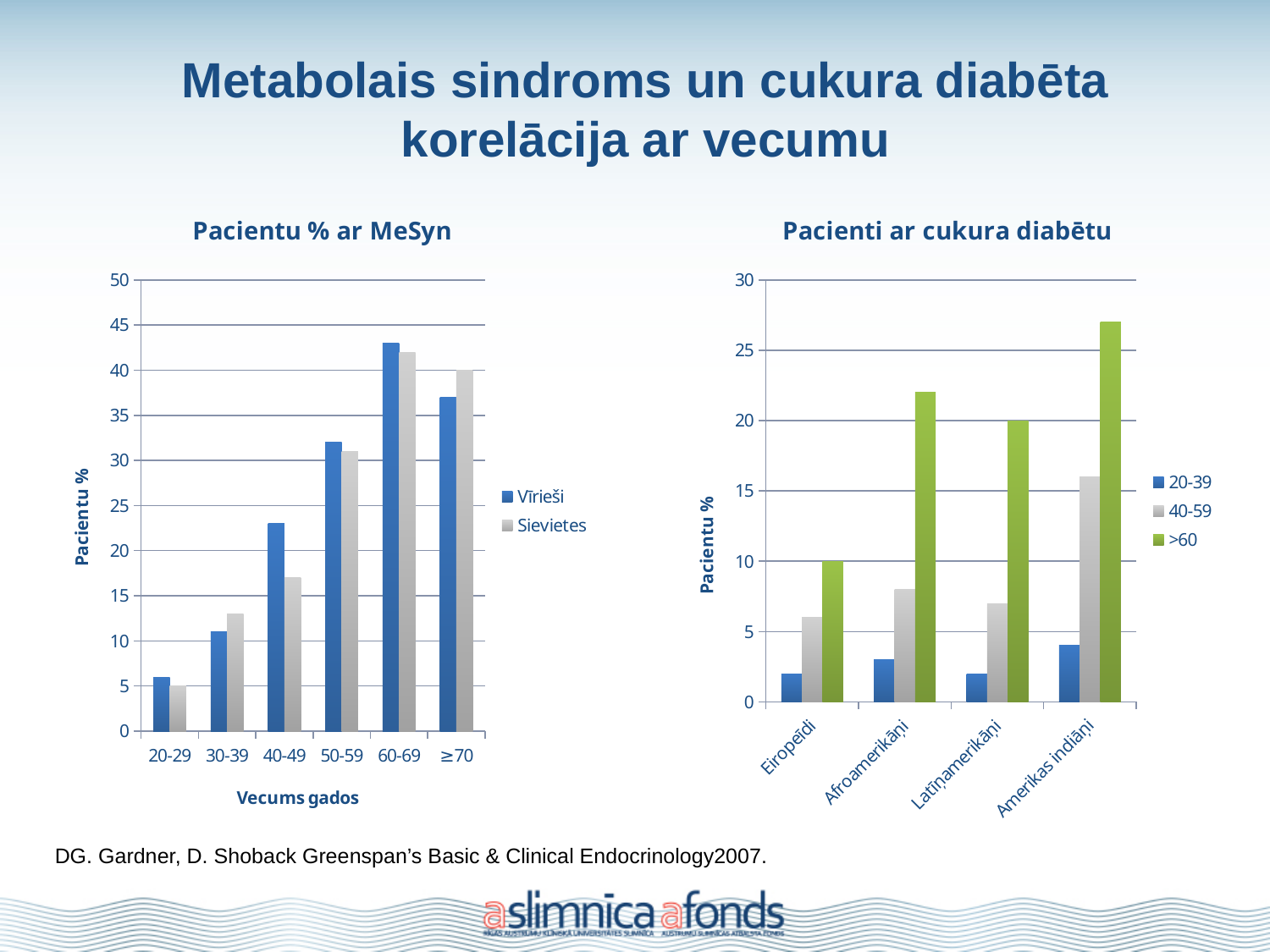
How many age categories are shown on the x axis of the 'Pacientu % ar MeSyn' chart? 6 What kind of chart is the 'Pacientu % ar MeSyn' chart on the left? bar chart In the 'Pacienti ar cukura diabētu' chart, for Amerikas indiāņi, which is larger: the 40-59 series or the 20-39 series? 40-59 In the 'Pacienti ar cukura diabētu' chart, is the >60 value for Afroamerikāņi greater or less than 20? greater In the 'Pacientu % ar MeSyn' chart, for the 40-49 age group, which is larger: Vīrieši or Sievietes? Vīrieši How many series does the legend of the 'Pacientu % ar MeSyn' chart list? 2 In the 'Pacientu % ar MeSyn' chart, which age group has the lowest value for Sievietes? 20-29 In the 'Pacientu % ar MeSyn' chart, which age group has the highest value for Vīrieši? 60-69 What is the x-axis title of the 'Pacientu % ar MeSyn' chart? Vecums gados In the 'Pacienti ar cukura diabētu' chart, which ethnic group has the highest value for the >60 series? Amerikas indiāņi How many series does the legend of the 'Pacienti ar cukura diabētu' chart list? 3 In the 'Pacientu % ar MeSyn' chart, is the Vīrieši value for 40-49 greater or less than 20? greater